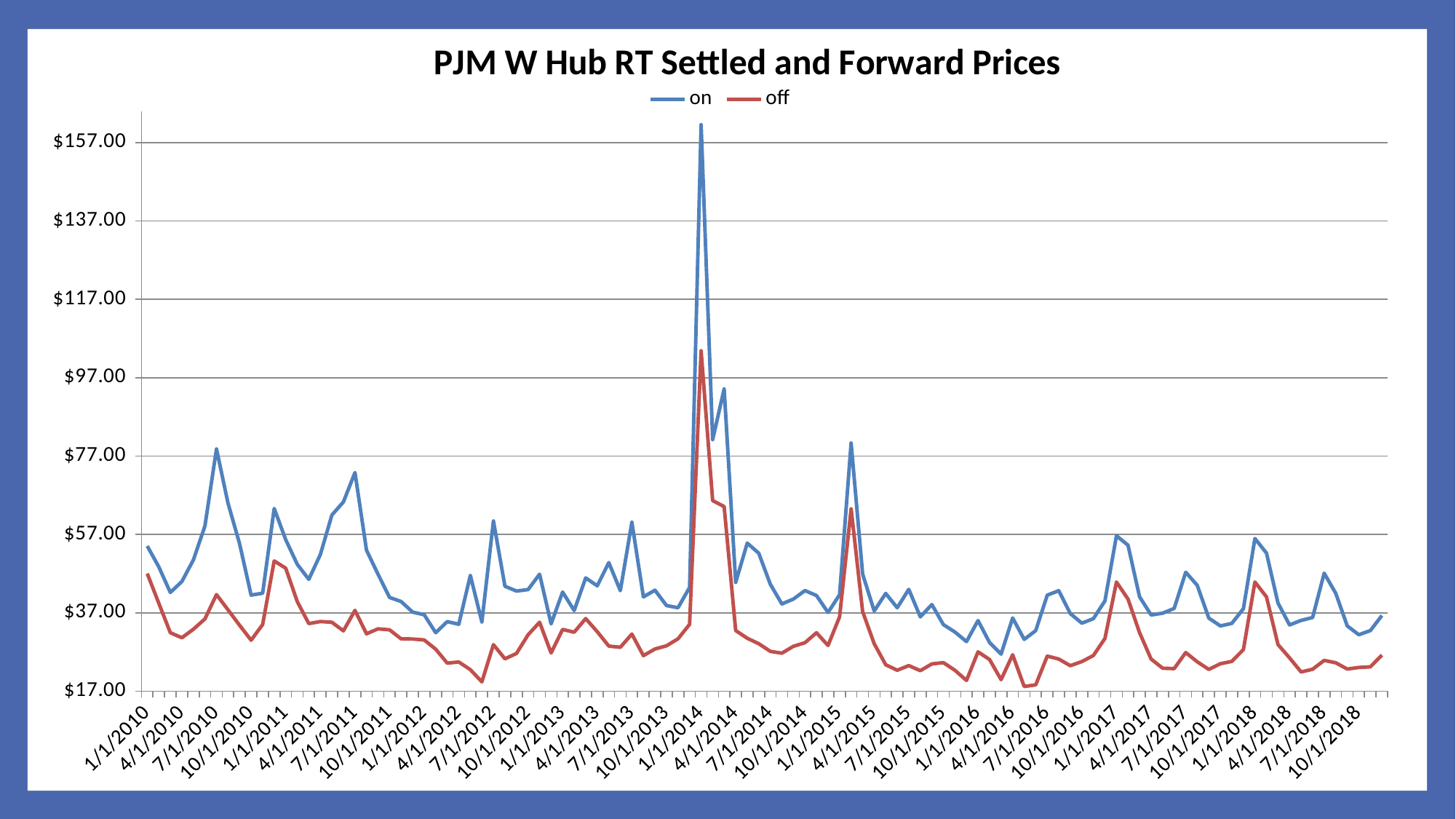
Which series reaches the highest value on the chart? on How many series does the legend list? 2 Is the value of the "off" series at 1/1/2016 greater or less than $37.00? less What is the title of the chart? PJM W Hub RT Settled and Forward Prices Which colour is used for the "off" series? red Near which x-axis label does the "on" series reach its highest value? 1/1/2014 Is the peak value of the "off" series near 1/1/2014 greater or less than $97.00? greater From 1/1/2010 to 10/1/2018, does the "off" series overall rise or fall? fall At the peak near 1/1/2014, which series is higher, "on" or "off"? on Is the value of the "on" series at 1/1/2010 greater or less than $37.00? greater What kind of chart is shown on the slide? line chart